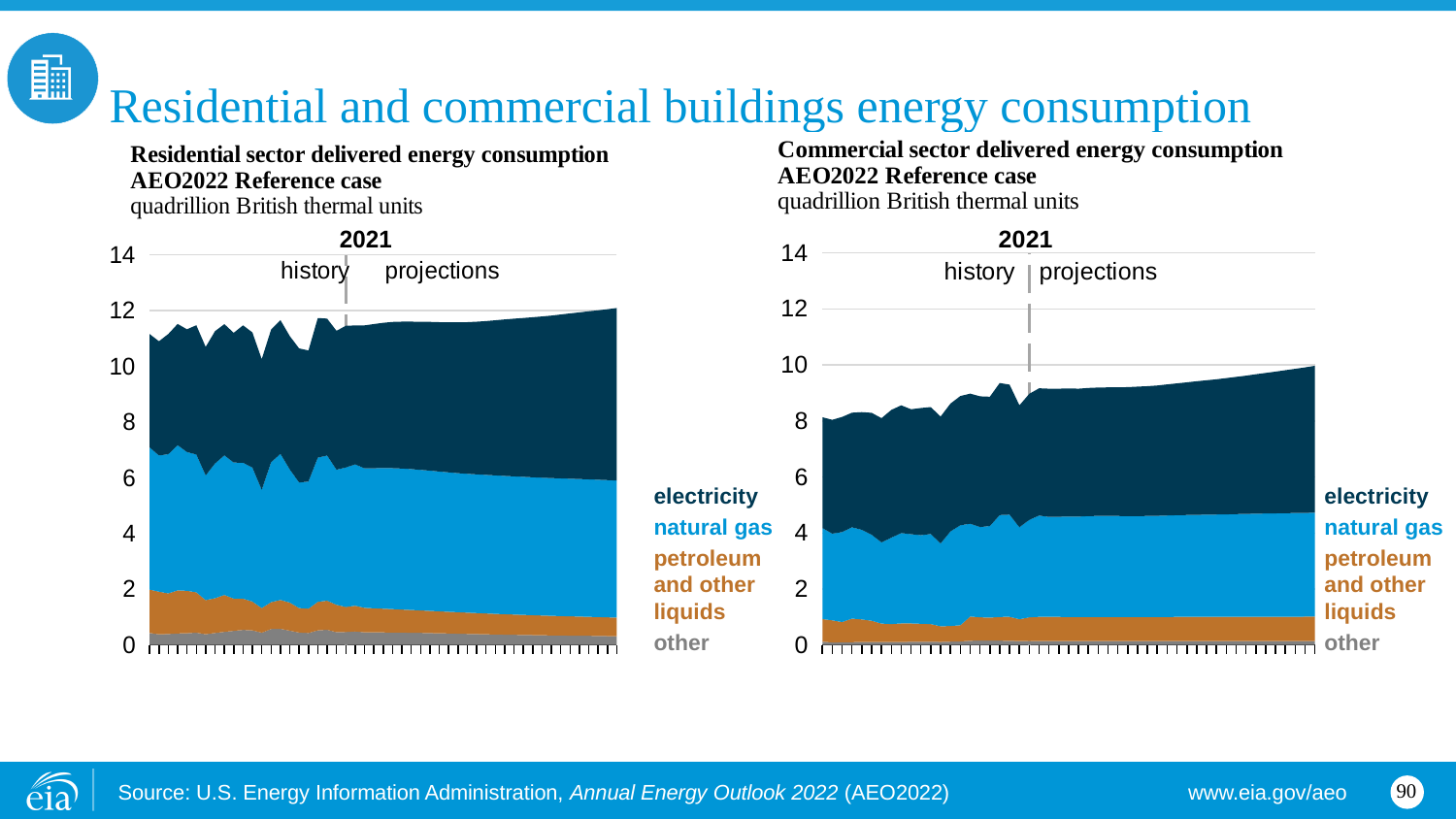
In the Residential sector chart, is the total delivered energy consumption at the end of the projection period greater or less than 10? greater Which year marks the boundary between history and projections in both charts? 2021 In the Commercial sector chart, is the total delivered energy consumption at the end of the projection period greater or less than 8? greater In the Residential sector chart, which series accounts for the smallest share of consumption? other Which sector has the higher total delivered energy consumption at the end of the projection period, residential or commercial? residential In the Commercial sector chart, which series accounts for the largest share of consumption at the end of the projection period? electricity In the Commercial sector chart, is the total delivered energy consumption at the start of the history period greater or less than 10? less In the Commercial sector chart, does total delivered energy consumption rise or fall over the projection period? rise What unit is used on the y axis of both charts? quadrillion British thermal units What kind of chart is the Residential sector delivered energy consumption chart? stacked area chart How many series does the legend of the Commercial sector delivered energy consumption chart list? 4 In the Residential sector chart, does the electricity series rise or fall over the projection period? rise